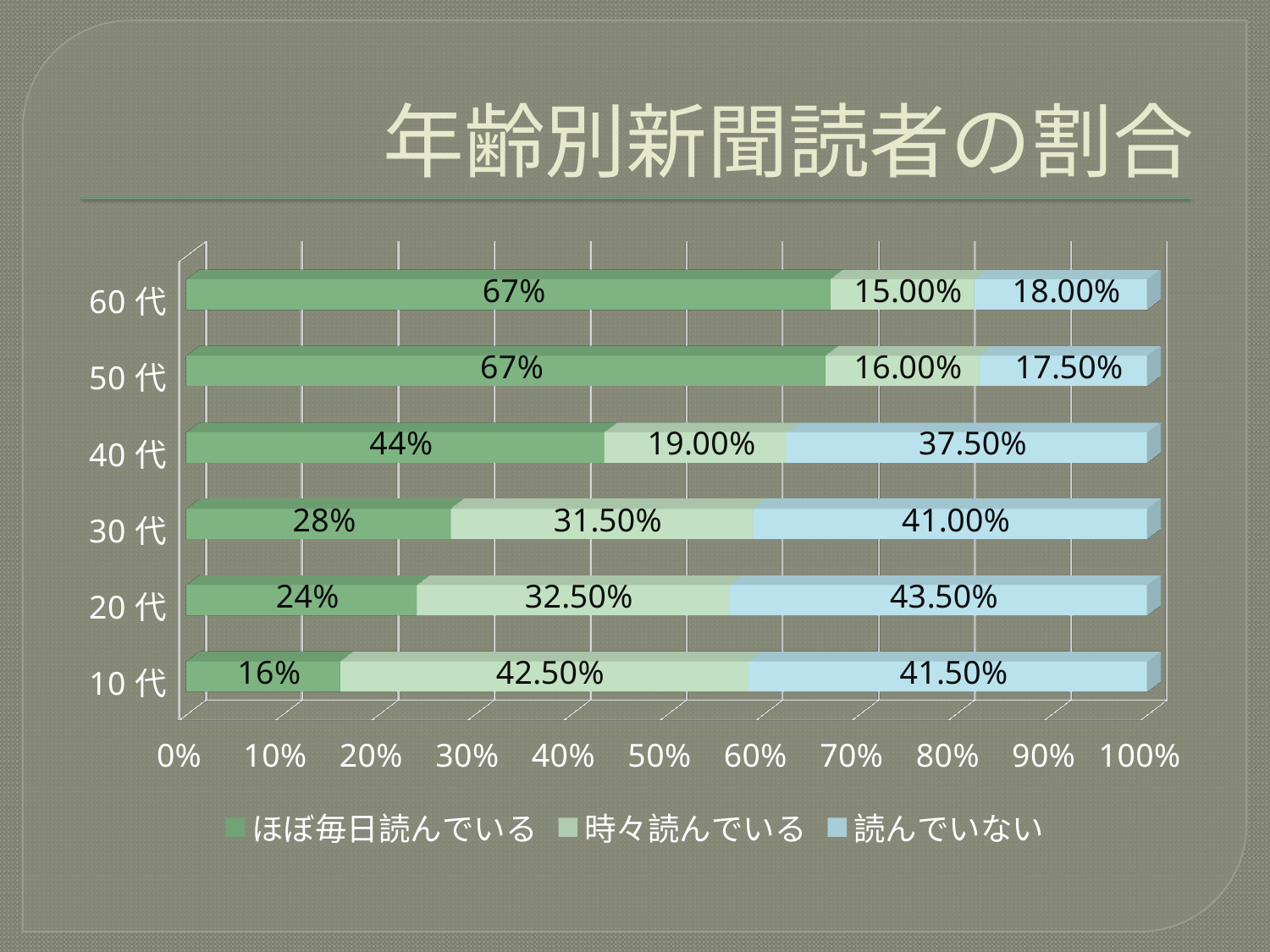
What is the value of ほぼ毎日読んでいる for 40代? 44% What kind of chart is shown on the slide? Stacked bar chart What is the title of the chart? 年齢別新聞読者の割合 Which age group has the highest value for 読んでいない? 20代 How many age groups are shown on the chart? 6 How many series does the legend list? 3 What is the value of 読んでいない for 50代? 17.50% Which age group has the lowest value for ほぼ毎日読んでいる? 10代 What is the difference between the ほぼ毎日読んでいる values for 40代 and 30代? 16% Which is larger, the 読んでいない value for 40代 or for 30代? 30代 Which age group has the highest value for 時々読んでいる? 10代 What is the value of 時々読んでいる for 30代? 31.50%